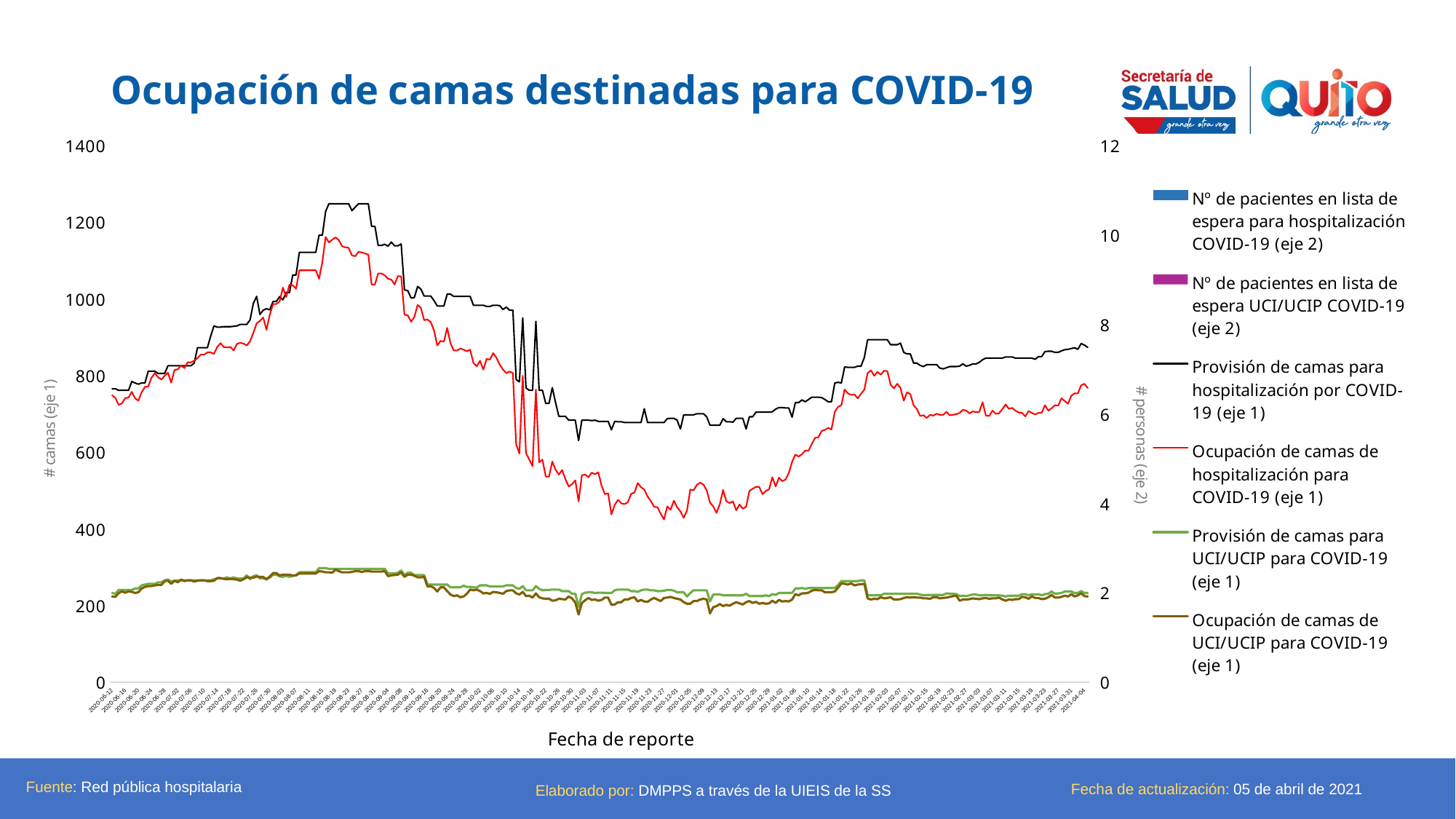
Does the red line (Ocupación de camas de hospitalización para COVID-19) rise or fall between 2020-06-12 and 2020-08-15? rise What is the title of the chart? Ocupación de camas destinadas para COVID-19 Does the black line (Provisión de camas para hospitalización por COVID-19) rise or fall between 2020-08-23 and 2020-11-03? fall How many series does the legend list? 6 Is the lowest value of the red line (Ocupación de camas de hospitalización para COVID-19) greater or less than 500? less What is the label of the x axis? Fecha de reporte Is the value of the black line (Provisión de camas para hospitalización por COVID-19) at the last date greater or less than 800? greater Which is higher around 2020-08-19: the black line (Provisión de camas para hospitalización) or the red line (Ocupación de camas de hospitalización)? Provisión de camas para hospitalización por COVID-19 (eje 1) Is the peak value of the black line (Provisión de camas para hospitalización por COVID-19) greater or less than 1200? greater Which series reaches the highest value on the chart? Provisión de camas para hospitalización por COVID-19 (eje 1) What kind of chart is shown on the slide? line chart